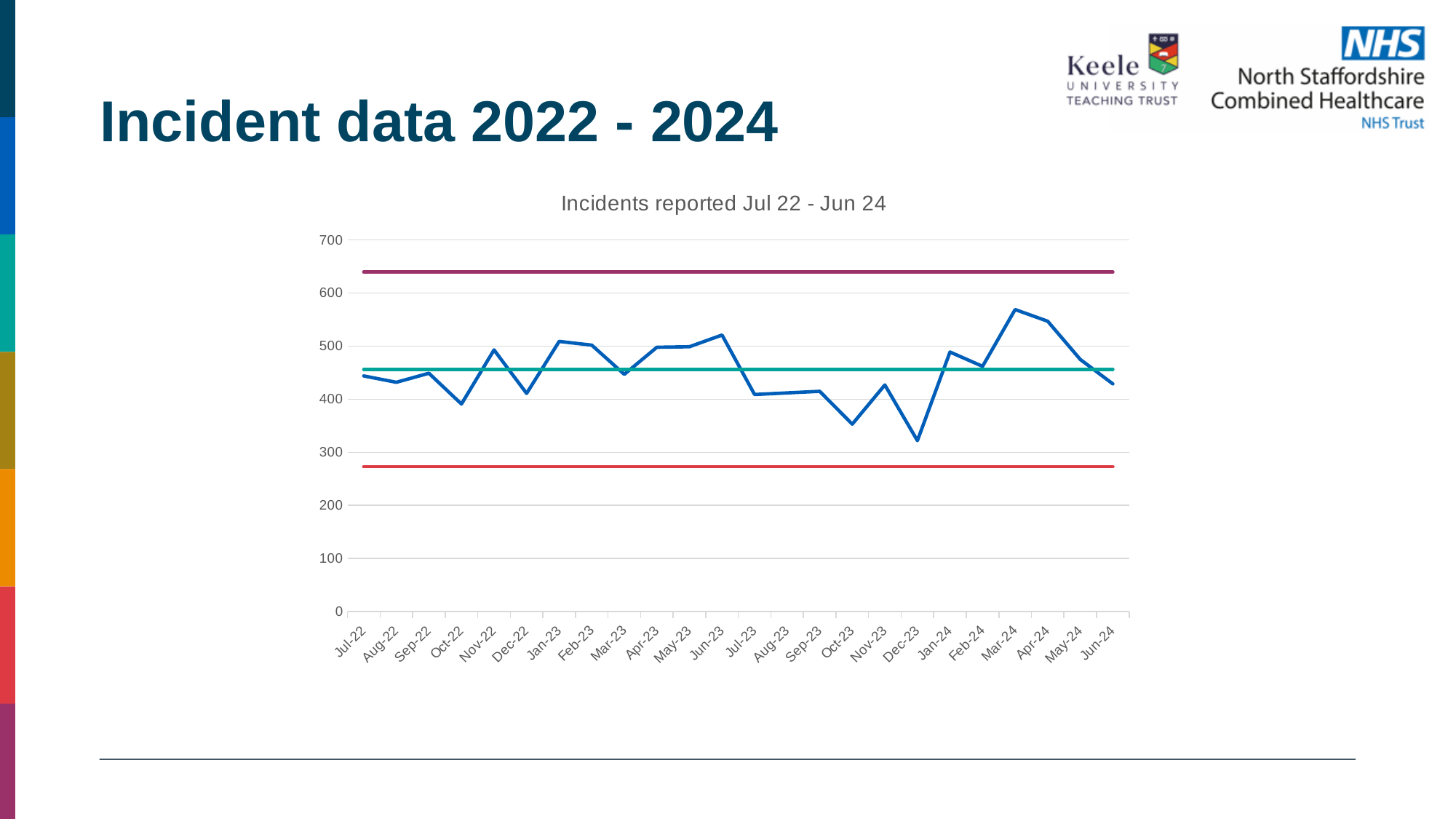
How many horizontal reference lines are drawn across the chart in addition to the blue data line? 3 What kind of chart is shown on the slide? line chart What is the title of the chart? Incidents reported Jul 22 - Jun 24 Is the value for Oct-23 greater or less than 400? less Is the value for Dec-23 greater or less than 400? less Is the value for Mar-24 greater or less than 500? greater Which month has the highest number of incidents reported? Mar-24 Which month has more incidents reported, Jun-23 or Jul-23? Jun-23 Do the incident values rise or fall from Mar-24 to Jun-24? fall How many monthly data points are plotted on the x axis? 24 Which month has the lowest number of incidents reported? Dec-23